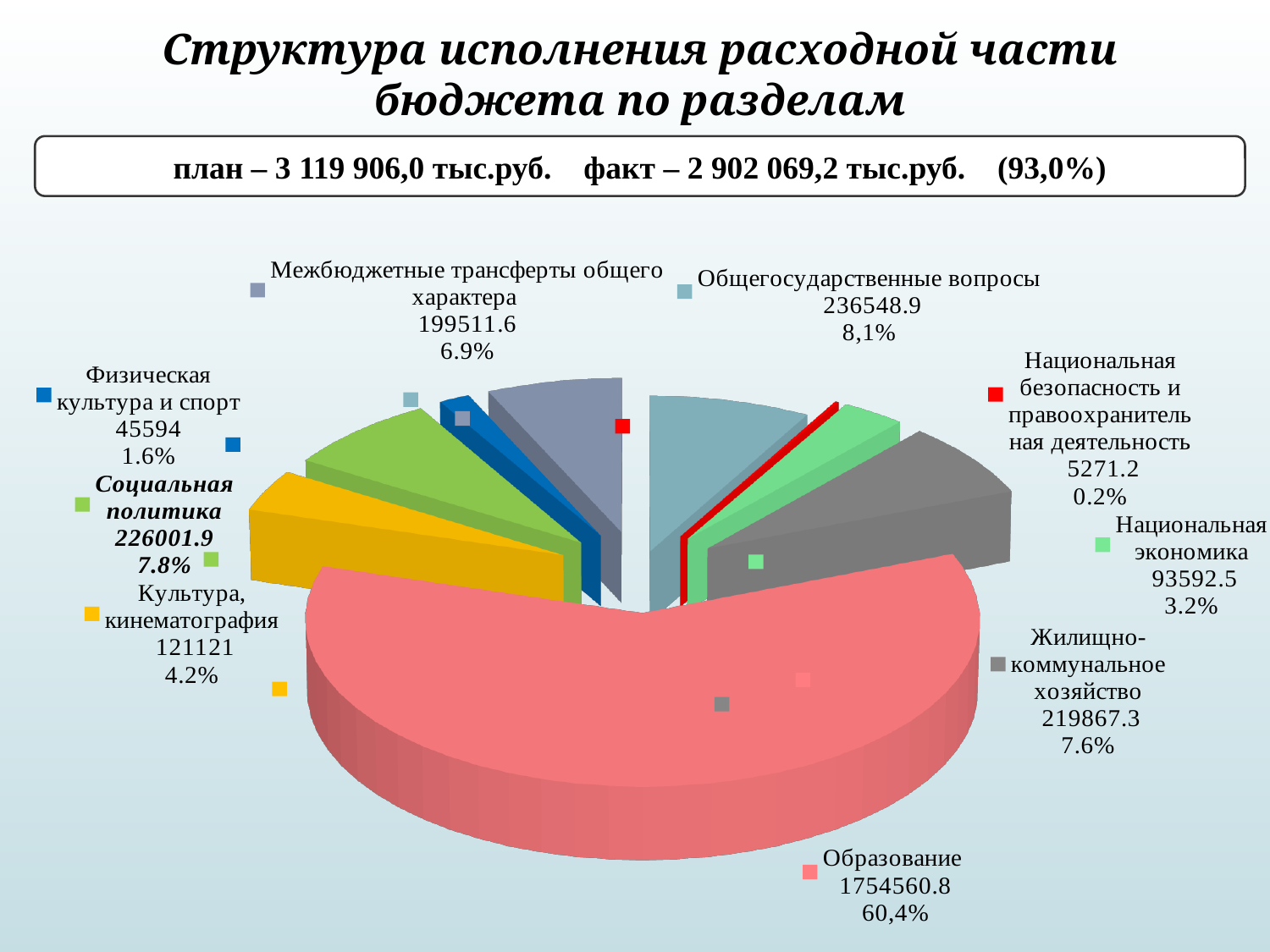
What percentage is shown for Национальная экономика? 3.2% What share of the pie does Образование account for? 60,4% What percentage is shown for Социальная политика? 7.8% Which category has the smallest slice of the pie? Национальная безопасность и правоохранительная деятельность Which is larger: Культура, кинематография or Физическая культура и спорт? Культура, кинематография Which category has the largest slice of the pie? Образование What is the value shown for Жилищно-коммунальное хозяйство? 219867.3 What is the value shown for Образование? 1754560.8 How many categories (slices) does the pie chart show? 9 What is the value shown for Общегосударственные вопросы? 236548.9 What is the difference between the values for Общегосударственные вопросы and Жилищно-коммунальное хозяйство? 16681.6 What kind of chart is shown on the slide? pie chart